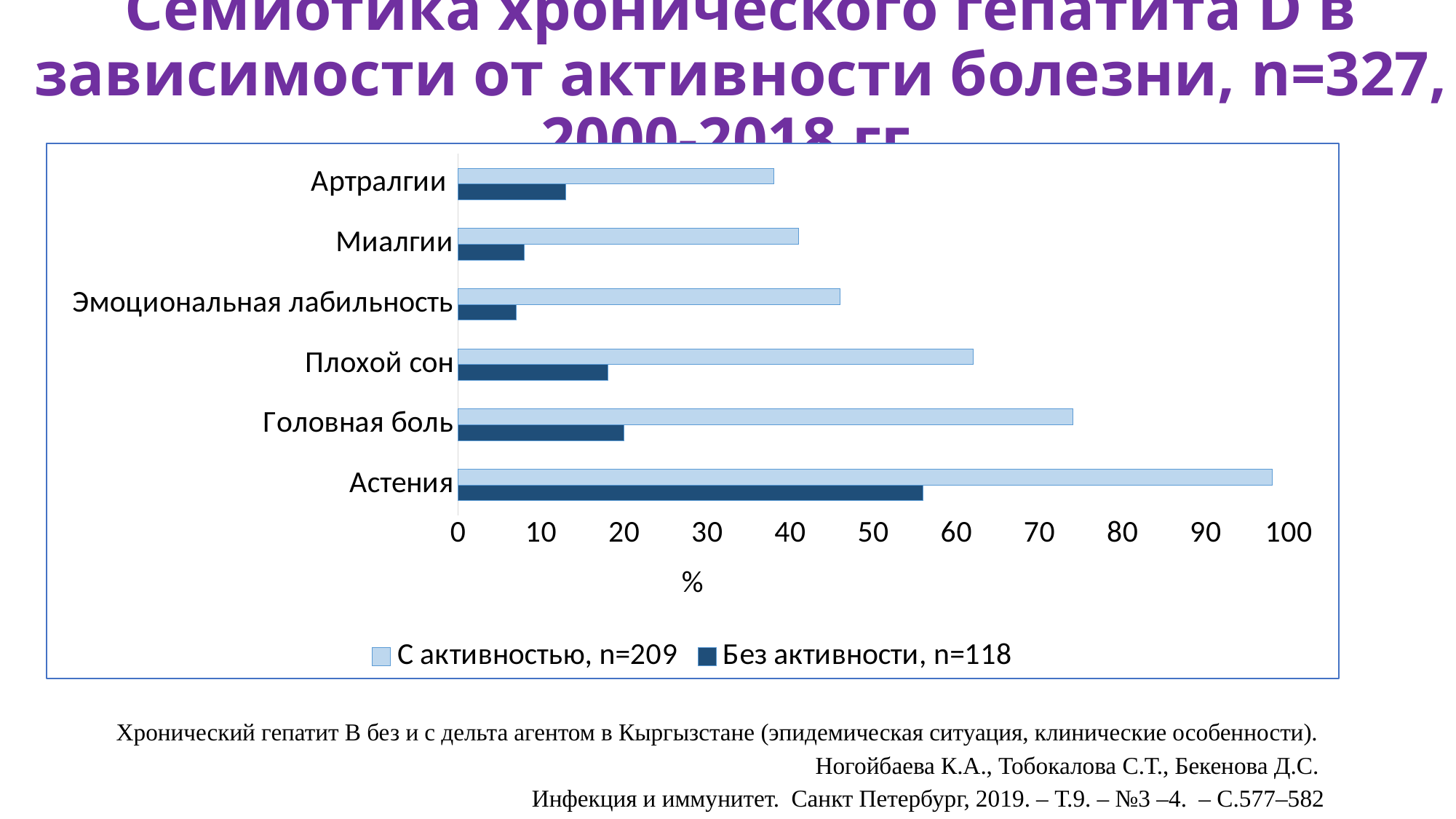
How many categories (symptoms) are plotted on the chart? 6 Is the value for Астения in the series "С активностью, n=209" greater or less than 90? greater Is the value for Миалгии in the series "Без активности, n=118" greater or less than 10? less How many series does the legend list? 2 For the series "Без активности, n=118", which is larger: Артралгии or Миалгии? Артралгии Is the value for Эмоциональная лабильность in the series "С активностью, n=209" greater or less than 50? less For the series "С активностью, n=209", which is larger: Головная боль or Плохой сон? Головная боль What is the label on the horizontal axis of the chart? % What kind of chart is shown on the slide? bar chart Which category has the highest value for the series "Без активности, n=118"? Астения Which category has the highest value for the series "С активностью, n=209"? Астения